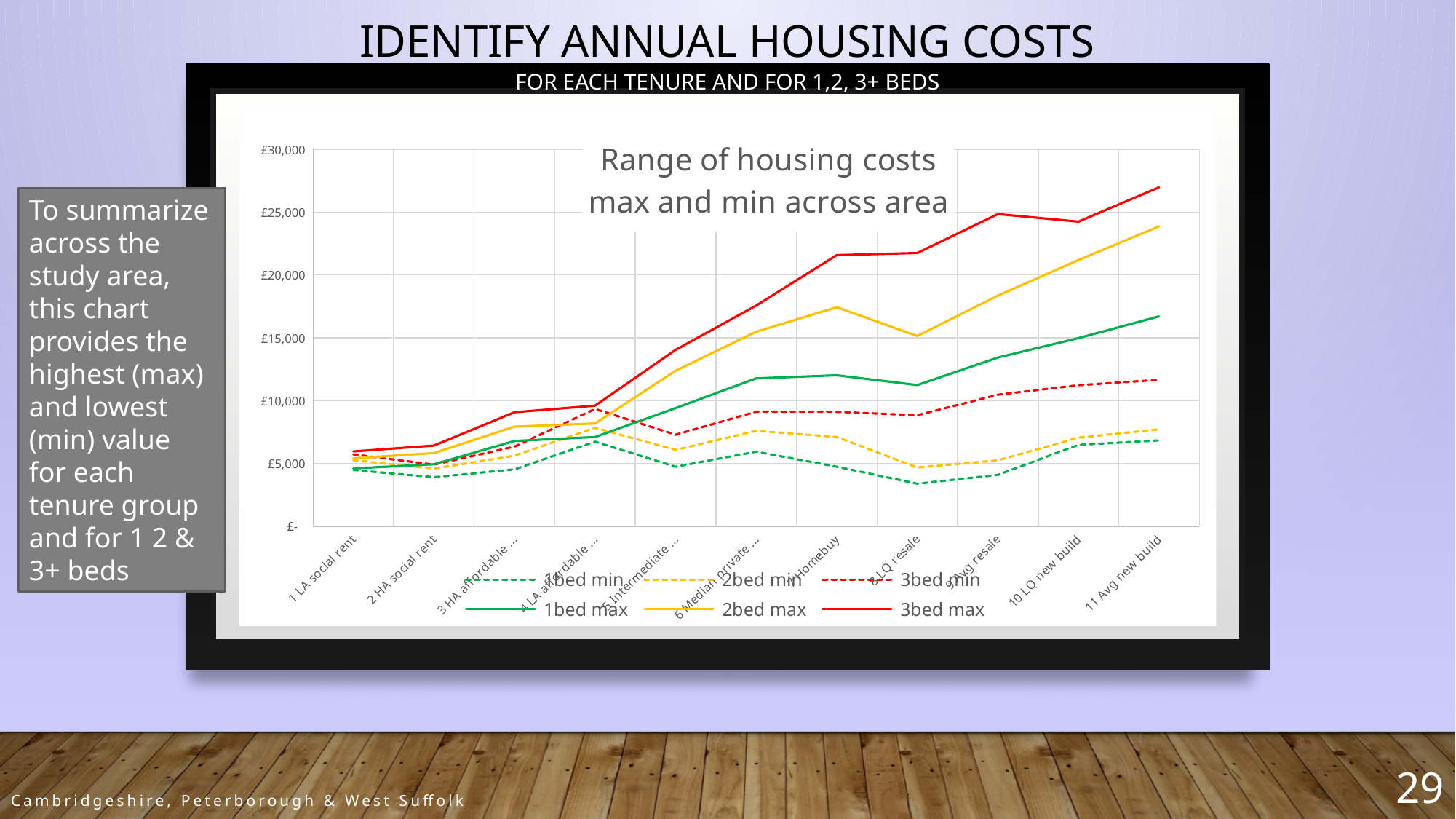
Does the 3bed max series generally rise or fall from 1 LA social rent to 11 Avg new build? rise Which category has the lowest value for the 1bed min series? 8 LQ resale Which category has the highest value for the 3bed max series? 11 Avg new build Is the value for 1bed min at 8 LQ resale greater or less than £5,000? less What kind of chart is shown on the slide? line chart How many categories are plotted along the x axis of the chart? 11 What colour is the 3bed max line in the chart? red At 11 Avg new build, which is larger: 3bed max or 2bed max? 3bed max Is the value for 3bed max at 11 Avg new build greater or less than £25,000? greater How many series does the chart legend list? 6 What is the title of the chart? Range of housing costs max and min across area Is the value for 1bed max at 7 Homebuy greater or less than £10,000? greater